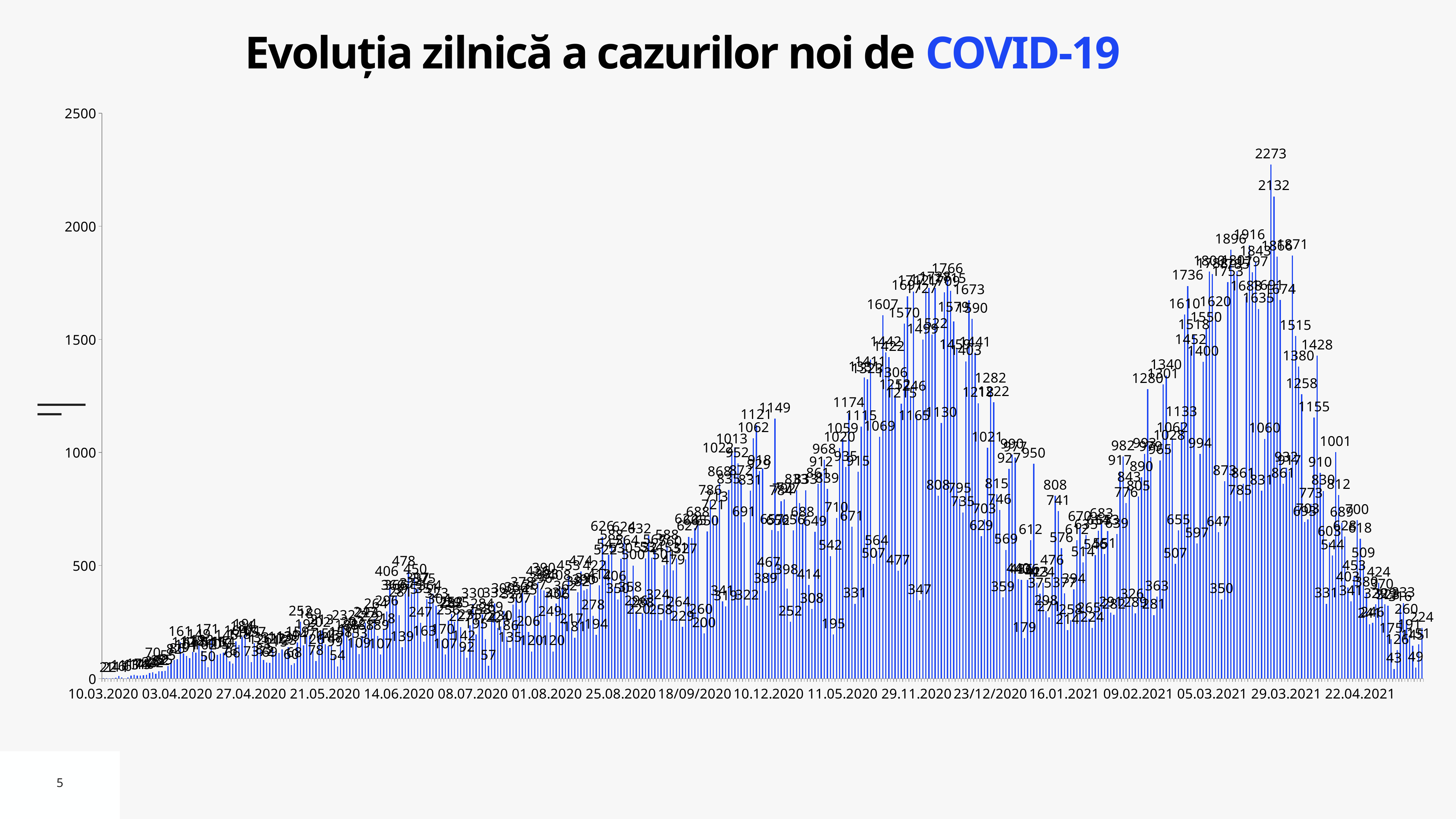
What is the maximum value shown on the vertical axis? 2500 What kind of chart is shown on the slide? bar chart What is the last date label on the horizontal axis? 22.04.2021 What is the title of the chart? Evoluția zilnică a cazurilor noi de COVID-19 What is the first date label on the horizontal axis? 10.03.2020 What is the second-highest daily value labelled on the chart, next to the 2273 peak? 2132 What is the highest daily value labelled on the chart? 2273 Is the highest bar on the chart greater or less than 2000? greater What is the difference between the two highest labelled values, 2273 and 2132? 141 Do the daily values generally rise or fall between 29.03.2021 and 22.04.2021? fall Do the daily values generally rise or fall between 10.03.2020 and 14.06.2020? rise Which is larger, the bar labelled 2273 or the bar labelled 2132? 2273